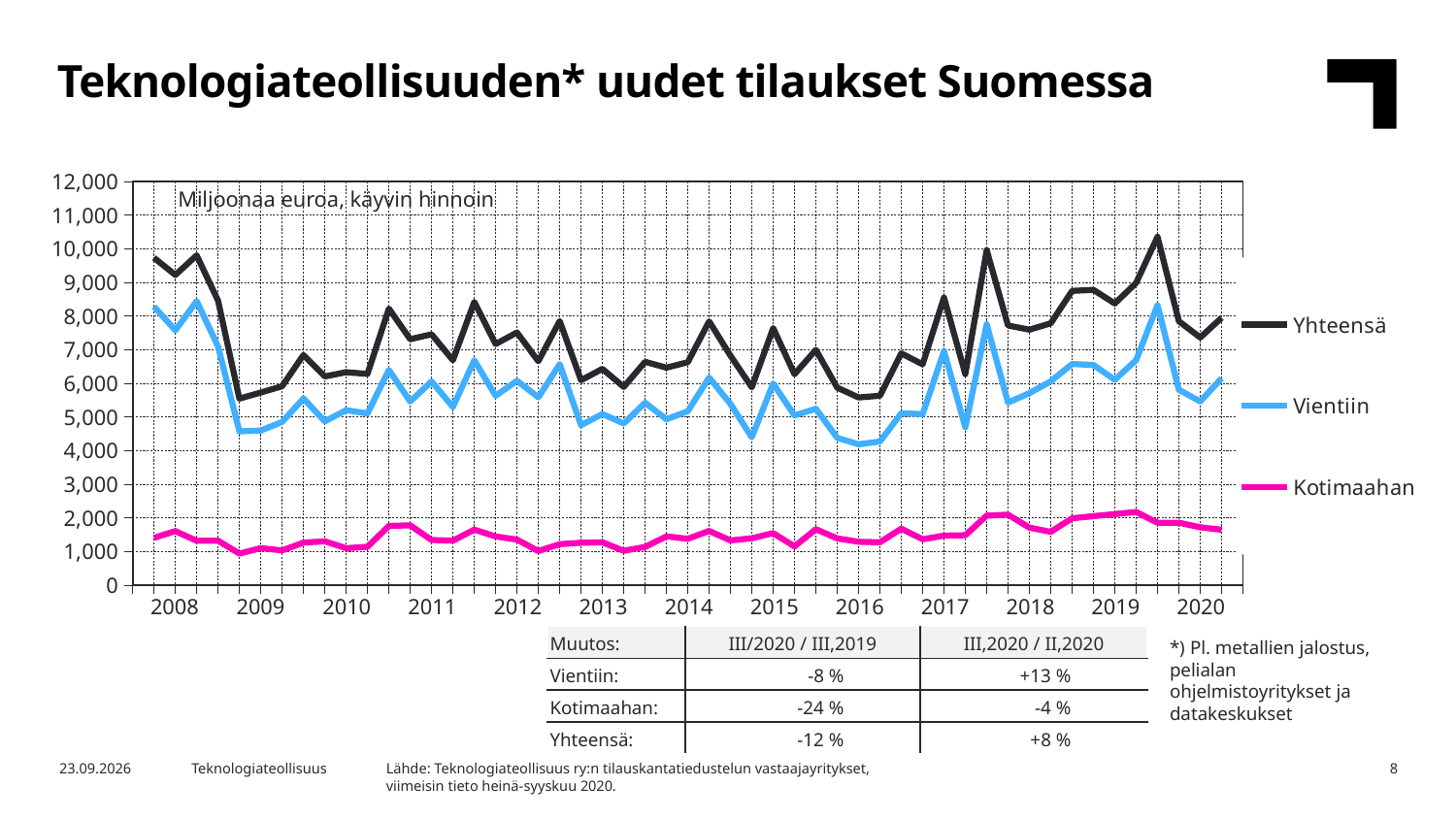
Which series has the lowest values throughout the chart? Kotimaahan Does the Yhteensä line rise or fall from the start of 2008 to the start of 2009? fall Is the Kotimaahan line ever greater or less than 3,000 across the whole period? less Which series is higher in 2020, Vientiin or Kotimaahan? Vientiin Which series has the highest values throughout the chart? Yhteensä What unit is stated in the text inside the plot area? Miljoonaa euroa, käyvin hinnoin What kind of chart is shown on the slide? line chart Is the peak value of the Yhteensä line in 2019 greater or less than 10,000? greater Is the lowest value of the Vientiin line, around 2016, greater or less than 5,000? less What are the three series named in the legend? Yhteensä, Vientiin, Kotimaahan How many year labels are shown on the x axis? 13 How many series does the legend list? 3